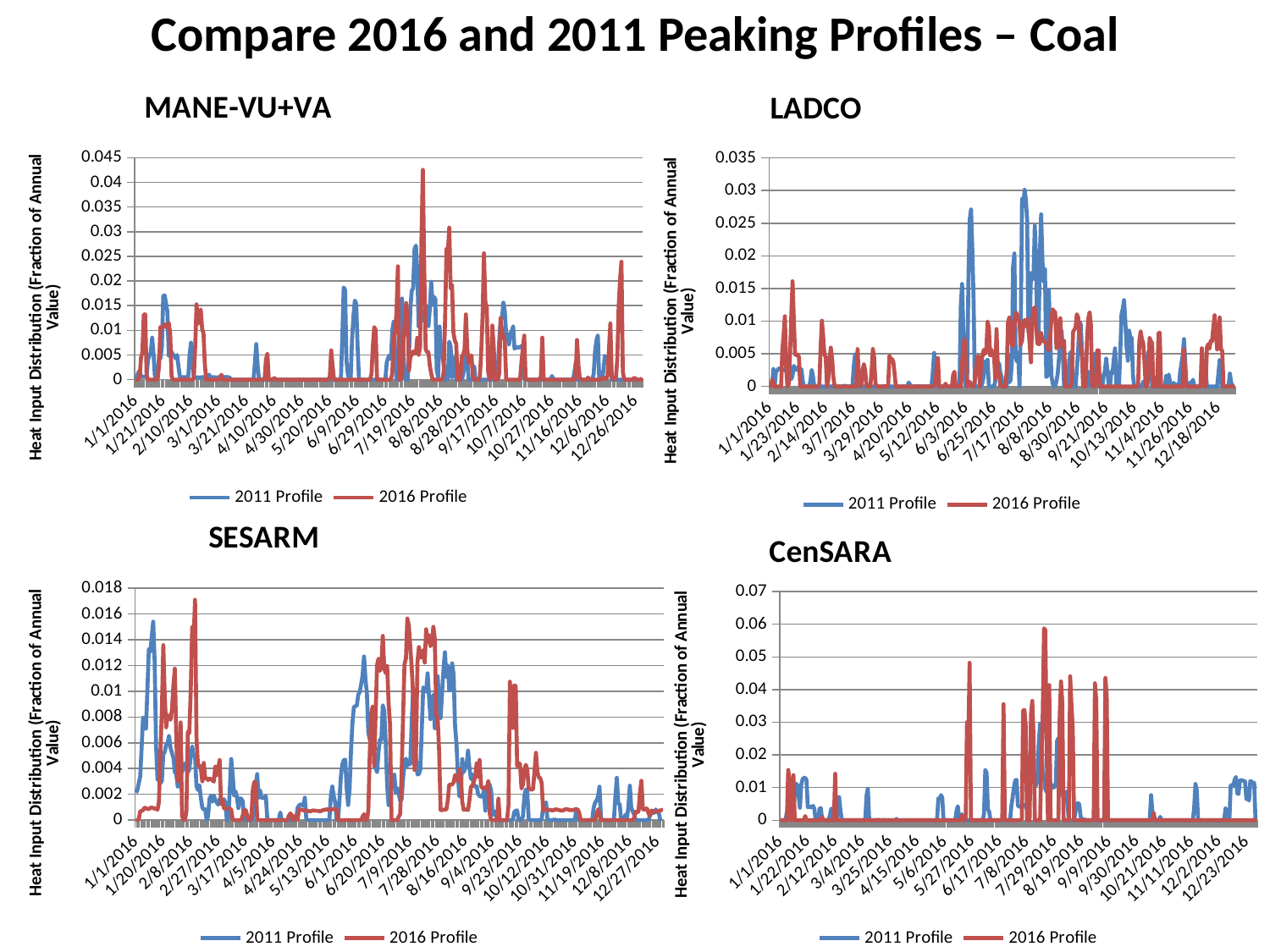
In the MANE-VU+VA chart, which series reaches the higher peak value, 2011 Profile or 2016 Profile? 2016 Profile What are the two series named in the legend of the SESARM chart? 2011 Profile and 2016 Profile In the CenSARA chart, is the highest peak of the 2016 Profile greater or less than 0.05? greater What colour is the 2016 Profile line in the CenSARA chart? red How many series does the legend of the LADCO chart list? 2 In the LADCO chart, which series reaches the higher peak value, 2011 Profile or 2016 Profile? 2011 Profile In the SESARM chart, is the highest peak of the 2016 Profile greater or less than 0.014? greater In the LADCO chart, is the 2016 Profile peak near 1/23/2016 greater or less than 0.02? less In the CenSARA chart, which series reaches the higher peak value, 2011 Profile or 2016 Profile? 2016 Profile What kind of chart is the MANE-VU+VA chart? line chart